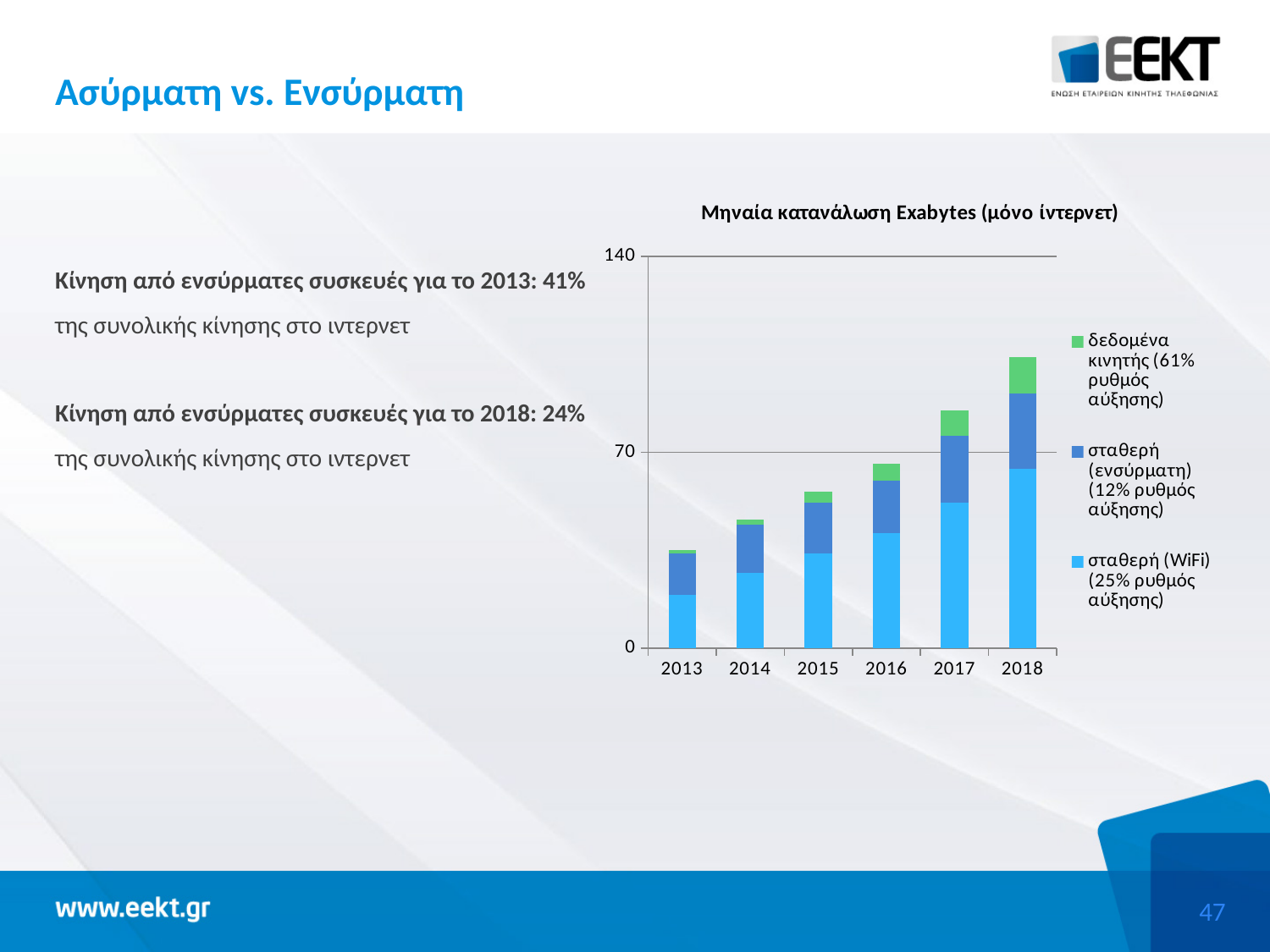
How many series does the chart's legend list? 3 Which is larger, the total bar for 2017 or the total bar for 2014? 2017 Is the total bar for 2018 greater or less than 70? greater How many years are shown on the x axis of the chart? 6 What is the title of the chart? Μηναία κατανάλωση Exabytes (μόνο ίντερνετ) Is the total bar for 2013 greater or less than 70? less Do the total bar heights rise or fall from 2013 to 2018? Rise Is the total bar for 2018 greater or less than 140? less Which year has the lowest total stacked bar? 2013 Which series is shown in green in the chart's legend? δεδομένα κινητής (61% ρυθμός αύξησης) What kind of chart is shown on the slide? Stacked bar chart Which year has the highest total stacked bar? 2018